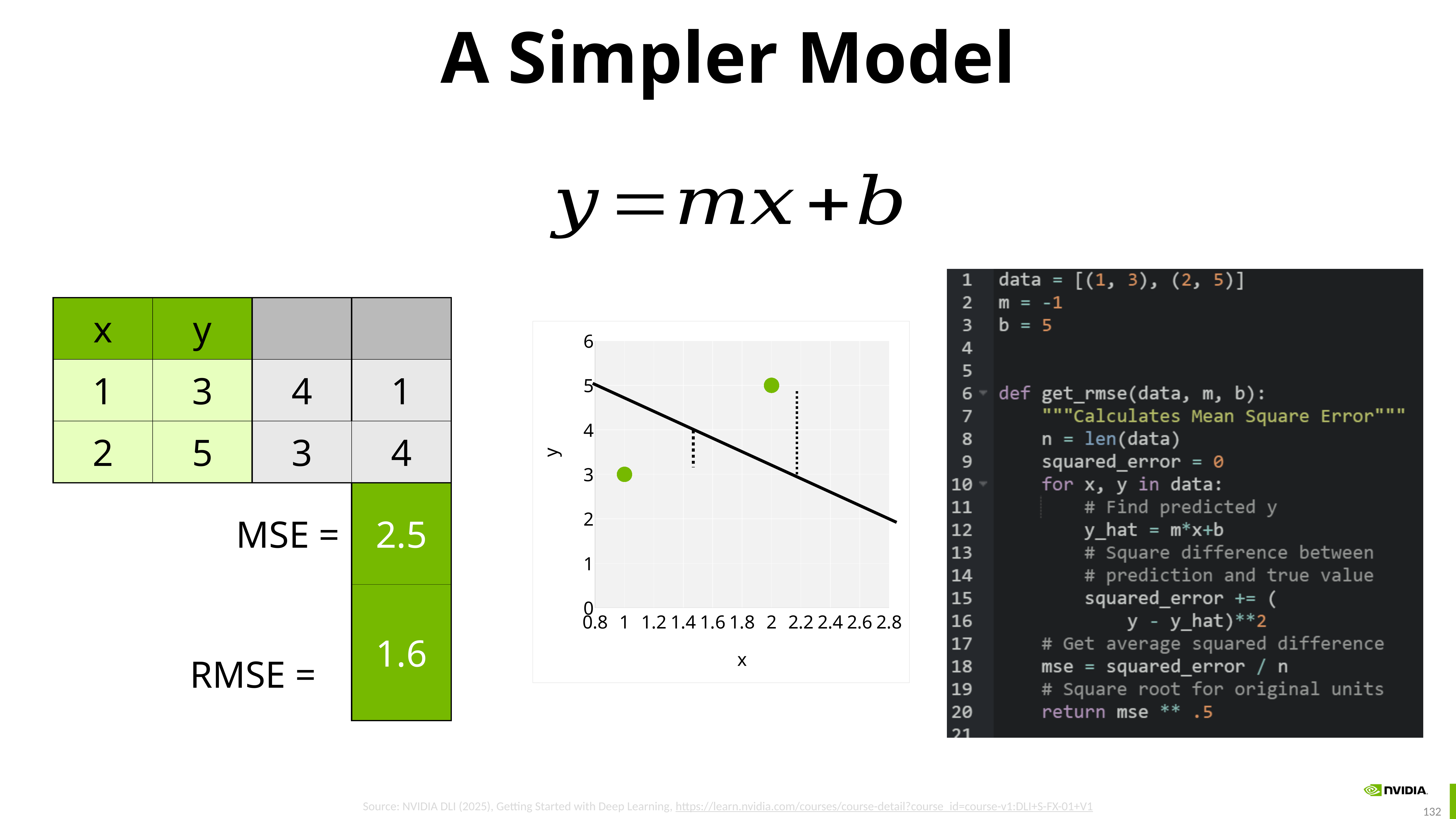
What kind of chart is shown in the middle of the slide? scatter chart What is the y value of the plotted point at x = 1? 3 What is the highest value shown on the y axis? 6 Does the fitted line rise or fall as x increases? fall What is the label of the horizontal axis? x Which plotted point has the higher y value, the one at x = 1 or the one at x = 2? x = 2 What is the y value of the plotted point at x = 2? 5 Is the value of the line at x = 2 greater or less than 4? less Do the plotted points rise or fall as x increases? rise Is the value of the line at x = 2.8 greater or less than 3? less How many data points are plotted on the chart? 2 What is the difference between the y values of the two plotted points? 2